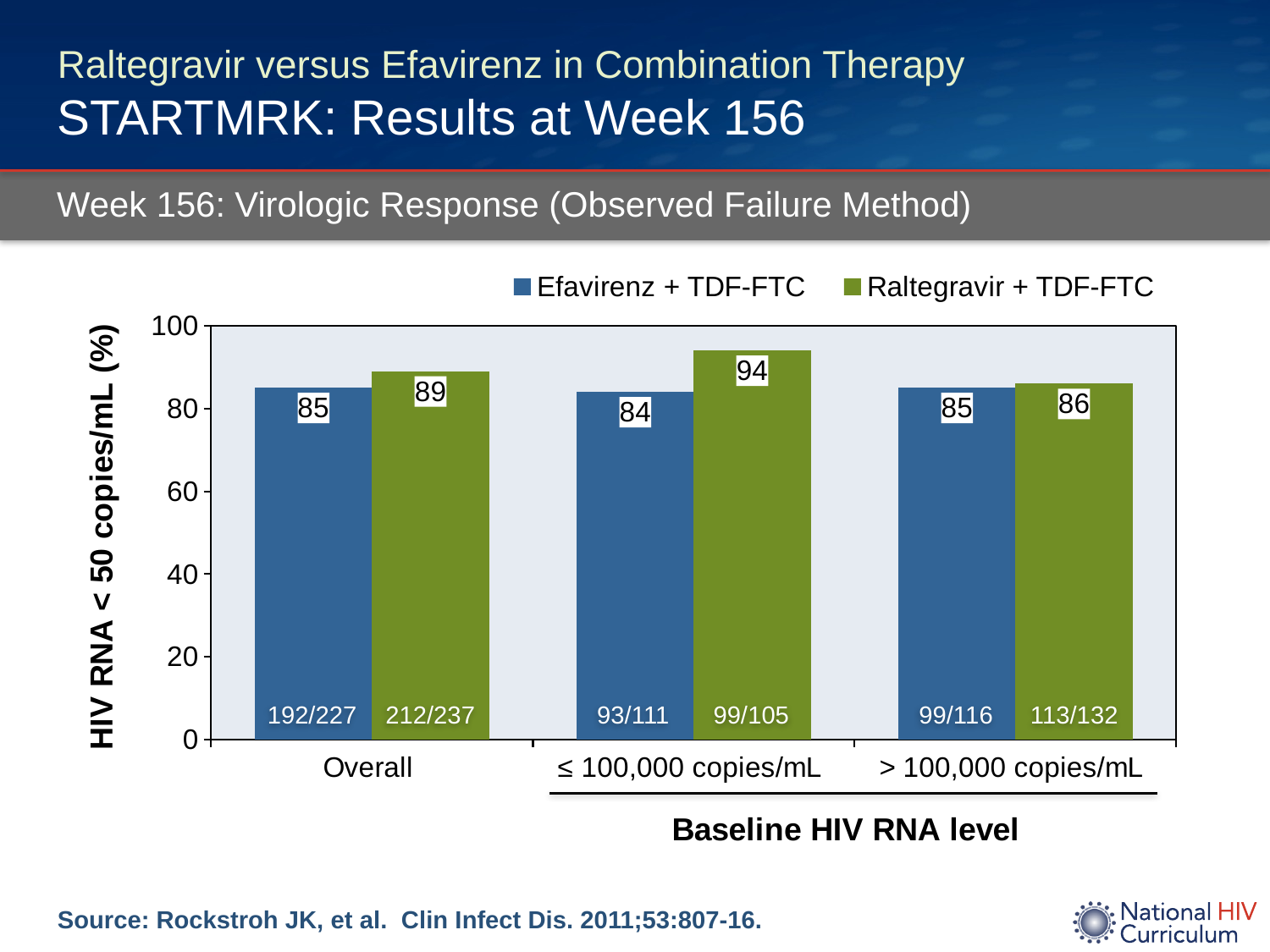
How many categories are shown on the x axis? 3 Which category has the lowest value for Efavirenz + TDF-FTC? ≤ 100,000 copies/mL Which category has the highest value for Raltegravir + TDF-FTC? ≤ 100,000 copies/mL What is the difference between the Raltegravir + TDF-FTC and Efavirenz + TDF-FTC values in the ≤ 100,000 copies/mL category? 10 What is the value for Raltegravir + TDF-FTC in the ≤ 100,000 copies/mL category? 94 What is the value for Efavirenz + TDF-FTC in the Overall category? 85 What is the fraction printed at the base of the Raltegravir + TDF-FTC bar in the Overall category? 212/237 What is the value for Raltegravir + TDF-FTC in the > 100,000 copies/mL category? 86 What is the value for Efavirenz + TDF-FTC in the ≤ 100,000 copies/mL category? 84 In the Overall category, which series has the larger value, Efavirenz + TDF-FTC or Raltegravir + TDF-FTC? Raltegravir + TDF-FTC What kind of chart is shown on the slide? Bar chart How many series does the legend list? 2